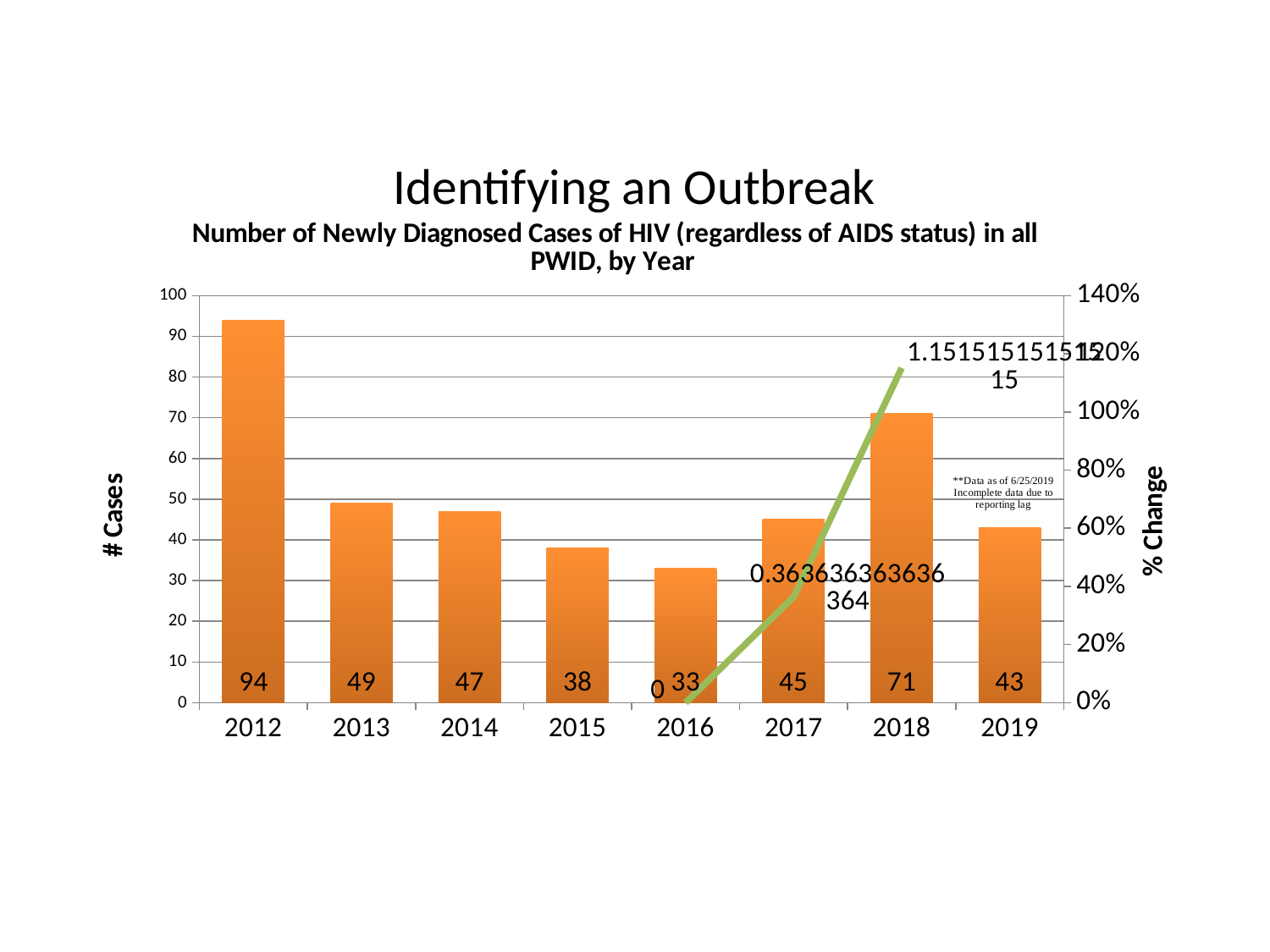
How many newly diagnosed HIV cases are shown for 2012? 94 Is the number of cases for 2015 greater or less than 40? less Which year has more cases, 2014 or 2019? 2014 What is the difference in cases between 2012 and 2013? 45 What kind of chart is used to show the number of cases? bar chart What is the difference in cases between 2018 and 2017? 26 What is the number of cases shown for 2018? 71 How many years are shown on the x axis? 8 What is the number of cases shown for 2016? 33 Which year has the lowest number of cases? 2016 Which year has the highest number of cases? 2012 What is the label of the left vertical axis? # Cases